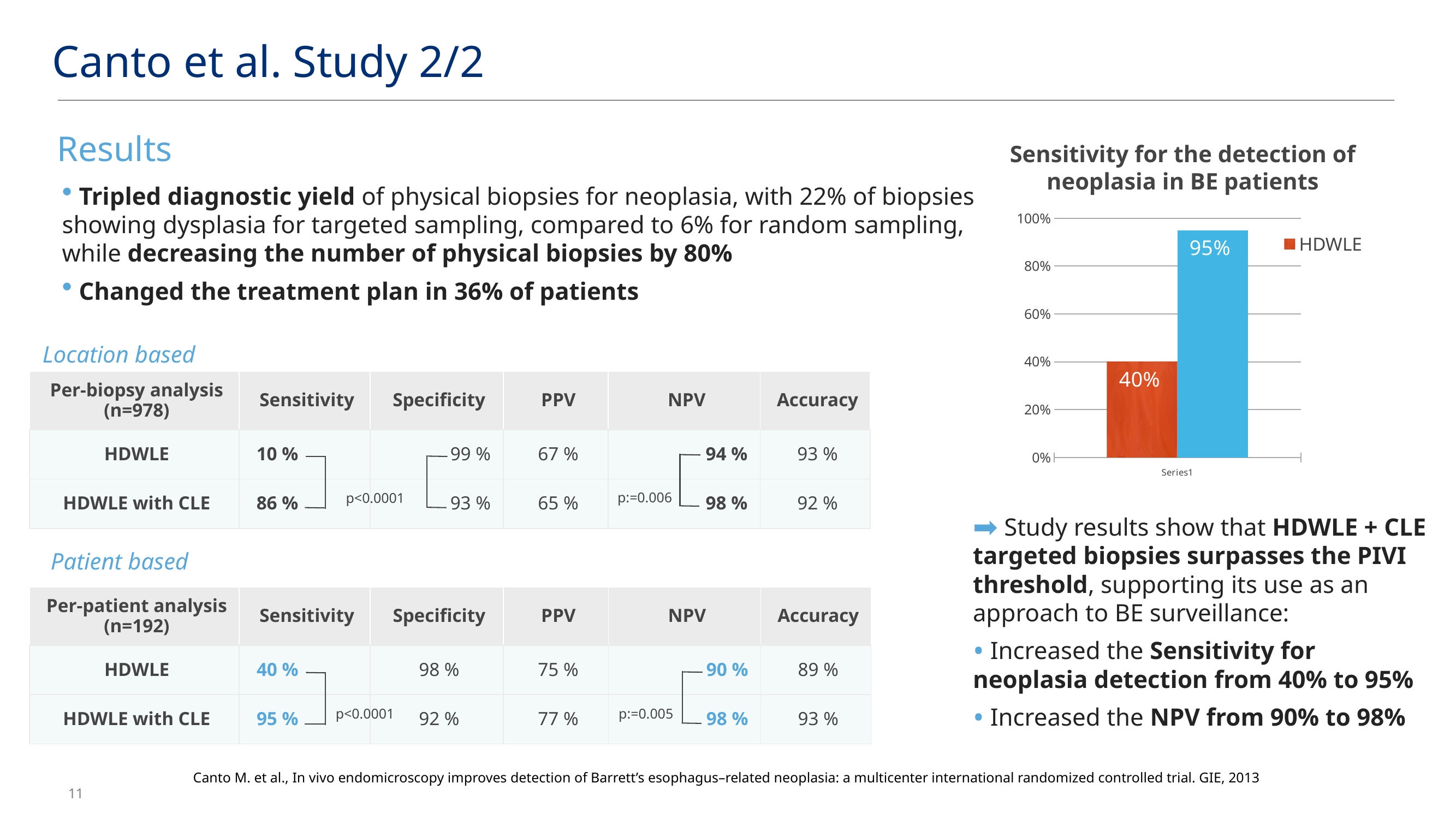
In the chart, what is the value shown on the blue bar? 95% What kind of chart is shown on the right of the slide? bar chart What is the only entry shown in the chart's legend? HDWLE How many bars are plotted in the chart? 2 What is the title of the chart on the right of the slide? Sensitivity for the detection of neoplasia in BE patients In the chart, what is the value of the tallest bar? 95% In the chart, what is the difference between the blue bar's value and the red bar's value? 55% In the chart, what is the value of the shortest bar? 40% In the chart, what is the value shown on the HDWLE (red) bar? 40% How many entries does the chart's legend list? 1 In the chart, is the value of the red HDWLE bar greater or less than 60%? less In the chart, which bar is taller, the red bar or the blue bar? the blue bar